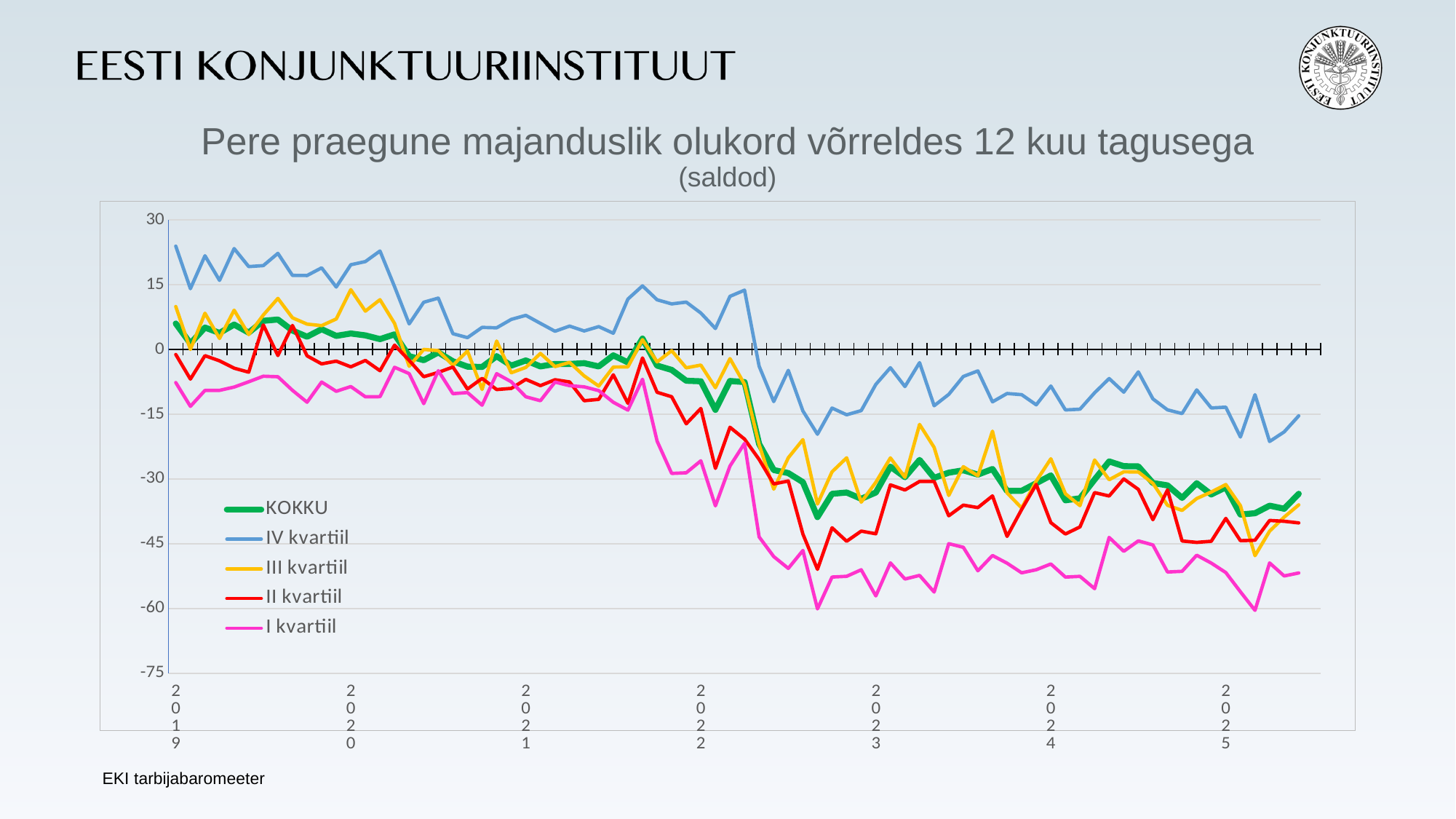
How many years are labelled on the x axis? 7 At the end of the series in 2025, which is larger: the value for IV kvartiil or the value for I kvartiil? IV kvartiil Which series is drawn with the thick green line? KOKKU How many series does the legend list? 5 What kind of chart is shown on the slide? line chart Is the value for I kvartiil at the start of 2019 greater or less than 0? less What is the title of the chart? Pere praegune majanduslik olukord võrreldes 12 kuu tagusega (saldod) Do the KOKKU values rise or fall overall from 2019 to 2025? fall Which series has the highest values at the start of 2019? IV kvartiil Which series has the lowest values across the whole period? I kvartiil Is the value for IV kvartiil at the start of 2019 greater or less than 15? greater Is the lowest value reached by I kvartiil greater or less than -45? less